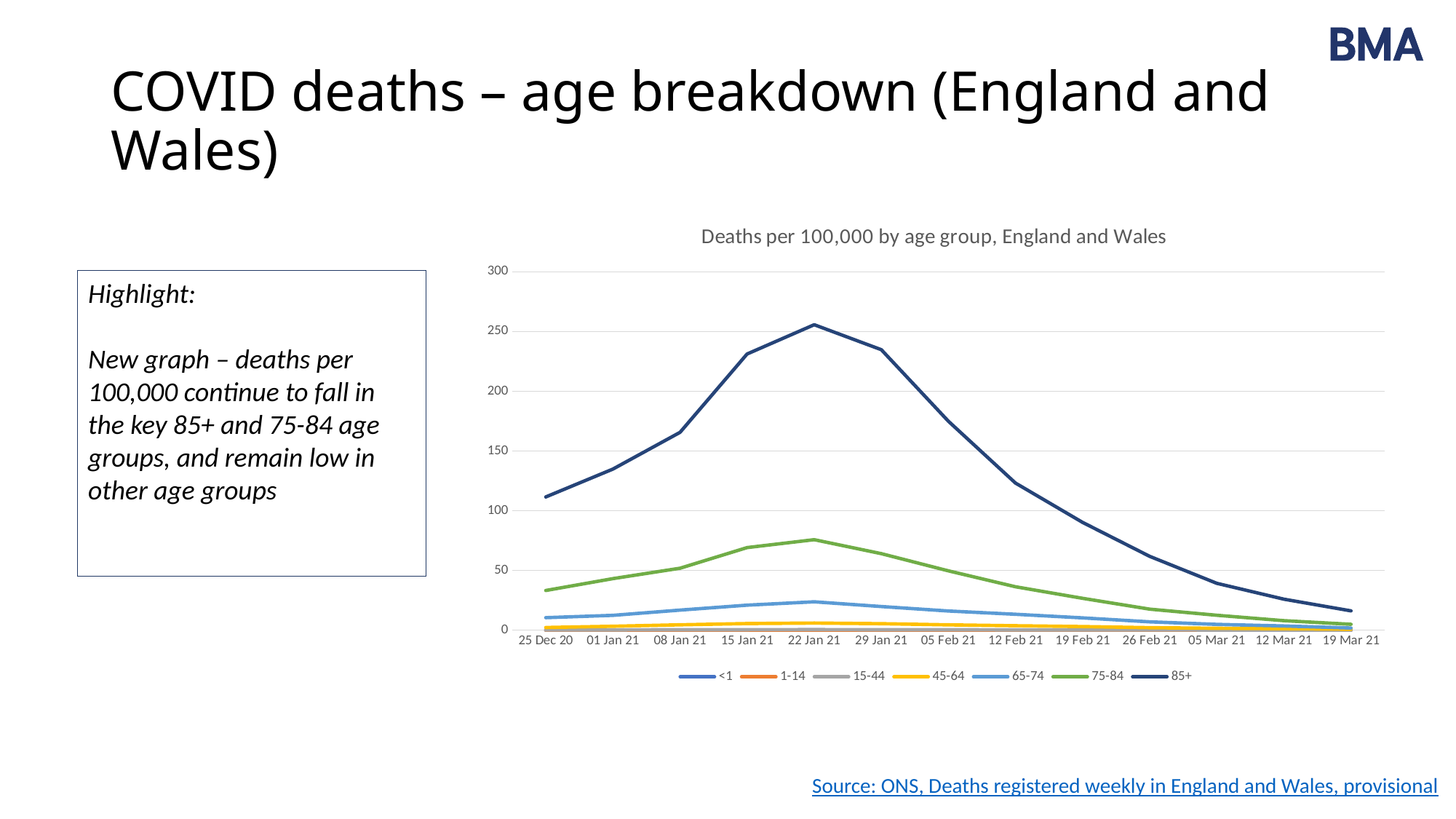
What kind of chart is shown on the slide? Line chart On which date does the 85+ line reach its peak? 22 Jan 21 Which age group has the highest deaths per 100,000 throughout the chart? 85+ How many series does the legend list? 7 How many dates are shown along the x axis? 13 Does the 85+ line rise or fall between 22 Jan 21 and 19 Mar 21? Falls Is the value for the 85+ age group on 25 Dec 20 greater or less than 100? greater Is the value for the 75-84 age group on 22 Jan 21 greater or less than 100? less Is the value for the 85+ age group on 19 Mar 21 greater or less than 50? less What is the title of the chart? Deaths per 100,000 by age group, England and Wales On 15 Jan 21, which age group has the higher value: 85+ or 75-84? 85+